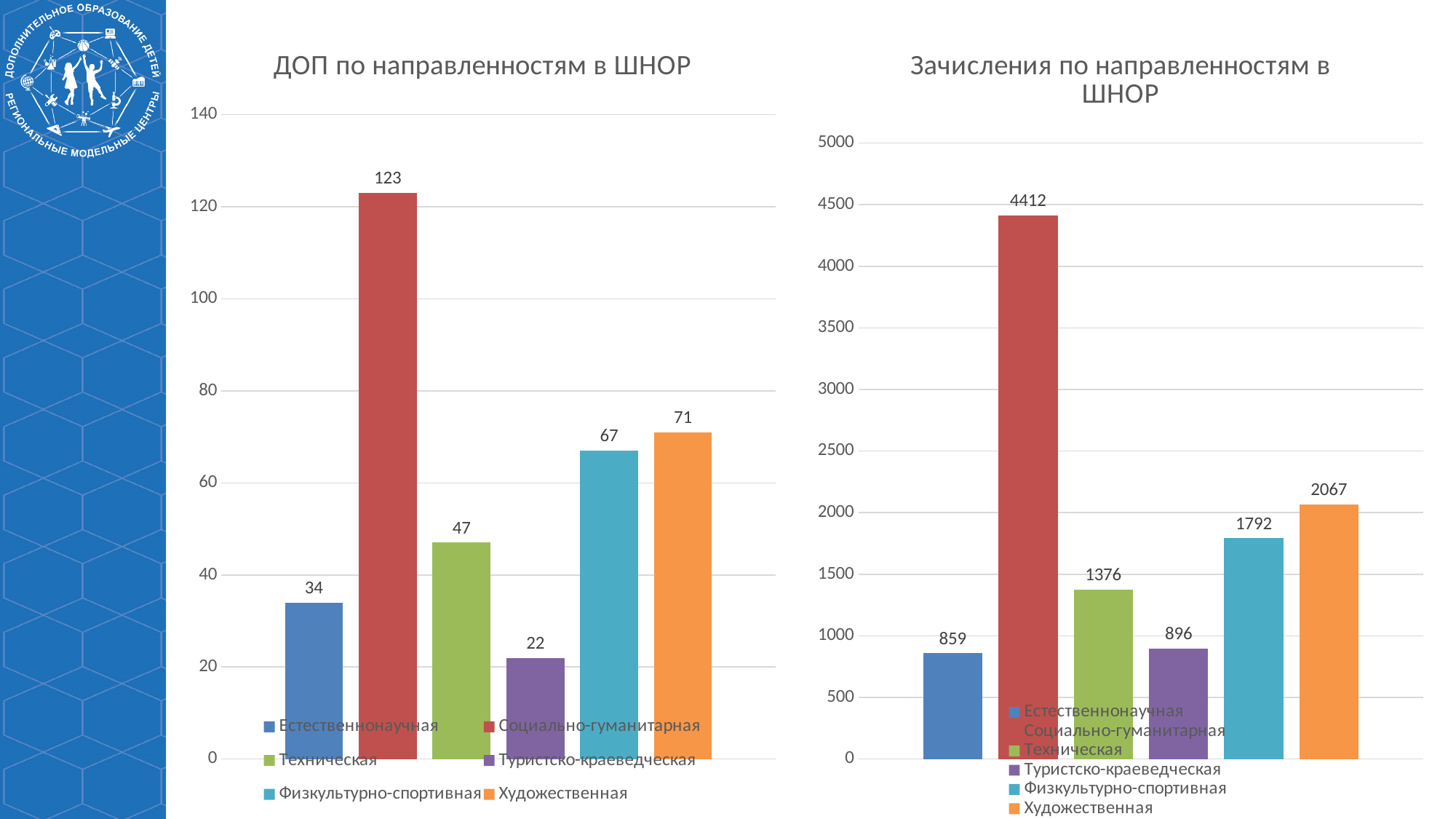
In the chart titled "ДОП по направленностям в ШНОР", how many entries does the legend list? 6 In the chart titled "Зачисления по направленностям в ШНОР", what is the value for Естественнонаучная? 859 In the chart titled "Зачисления по направленностям в ШНОР", what is the value for Физкультурно-спортивная? 1792 In the chart titled "ДОП по направленностям в ШНОР", what is the value for Социально-гуманитарная? 123 In the chart titled "Зачисления по направленностям в ШНОР", what is the difference between Художественная and Техническая? 691 In the chart titled "ДОП по направленностям в ШНОР", which is larger: Естественнонаучная or Техническая? Техническая In the chart titled "ДОП по направленностям в ШНОР", which category has the lowest value? Туристско-краеведческая In the chart titled "ДОП по направленностям в ШНОР", what is the difference between Художественная and Физкультурно-спортивная? 4 In the chart titled "Зачисления по направленностям в ШНОР", which is larger: Естественнонаучная or Туристско-краеведческая? Туристско-краеведческая What type of chart is the chart titled "Зачисления по направленностям в ШНОР"? Bar chart In the chart titled "ДОП по направленностям в ШНОР", how many categories are plotted? 6 In the chart titled "Зачисления по направленностям в ШНОР", which category has the highest value? Социально-гуманитарная